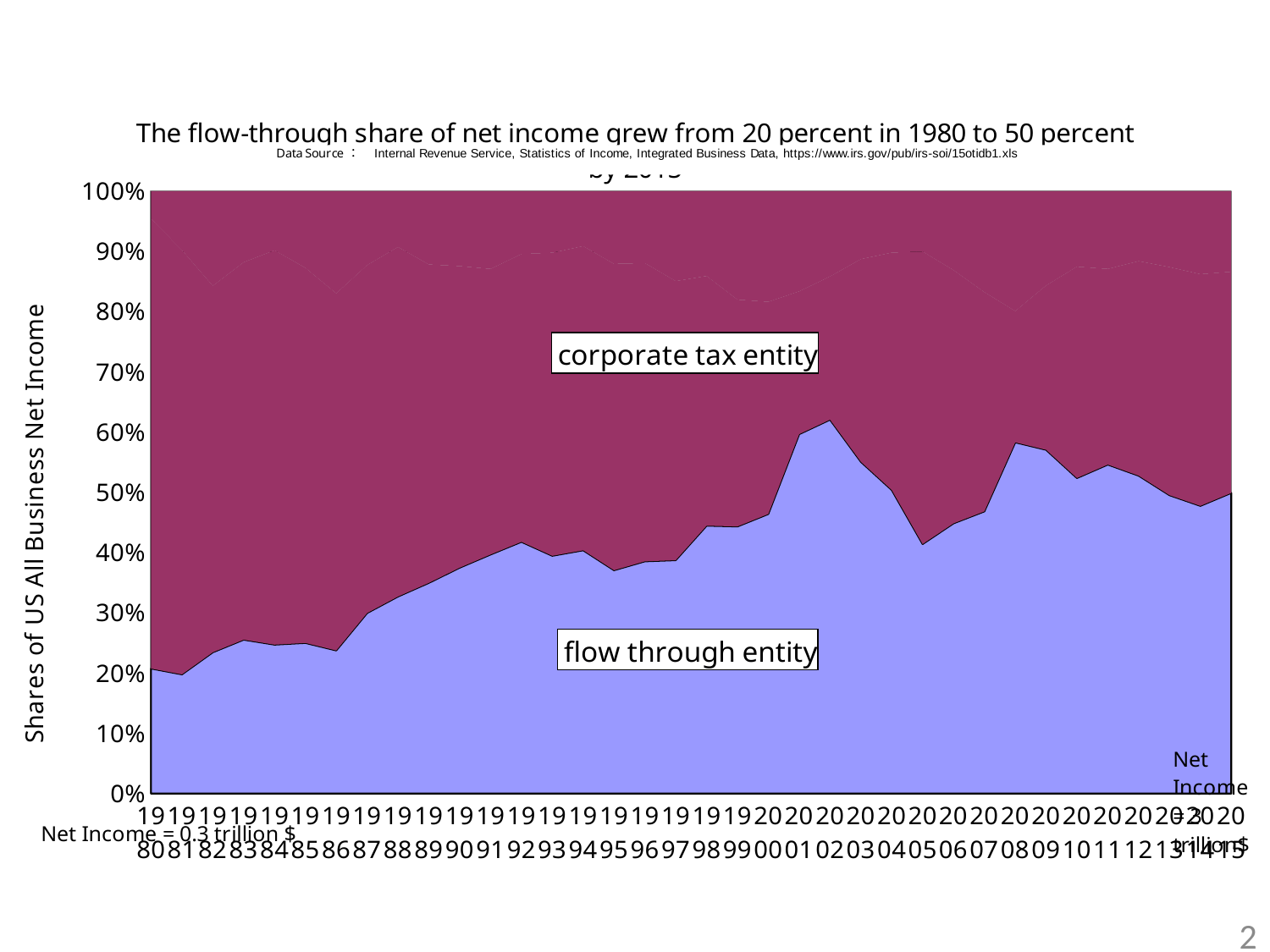
What kind of chart is shown on the slide? area chart Is the flow through entity share in 1980 greater or less than 30%? less Is the corporate tax entity share in 1980 greater or less than 70%? greater How many years are plotted along the x axis of the chart? 36 Which is larger in 1980, the flow through entity share or the corporate tax entity share? corporate tax entity How many series are plotted in the chart? 3 What is the label on the vertical axis of the chart? Shares of US All Business Net Income Is the flow through entity share in 2002 greater or less than 50%? greater What are the two series shown in the chart? flow through entity and corporate tax entity In which year does the flow through entity share reach its highest point? 2002 Does the flow through entity share generally rise or fall from 1980 to 2015? rise